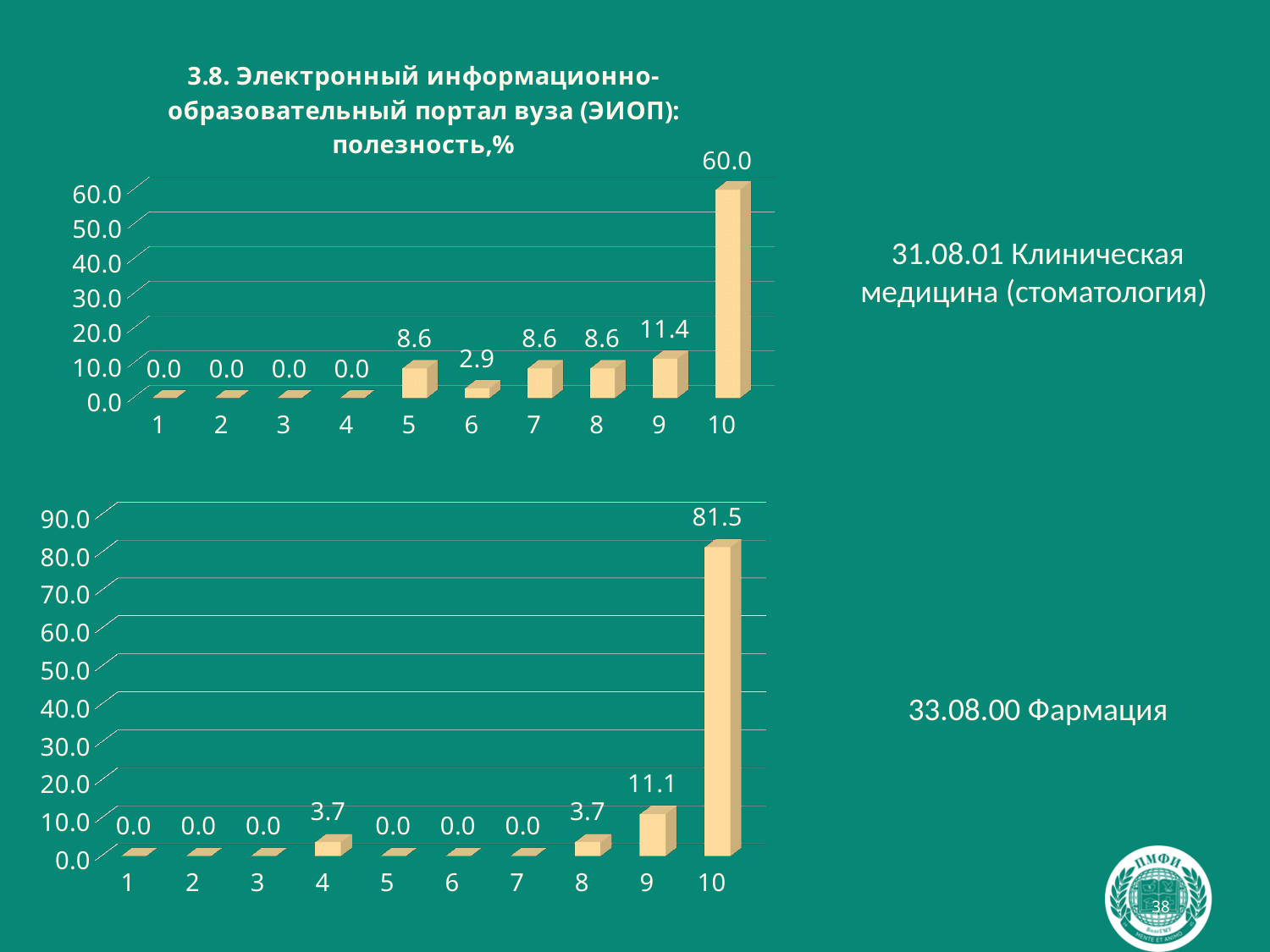
In the bottom chart (33.08.00 Фармация), what is the value for category 9? 11.1 In the top chart (31.08.01 Клиническая медицина), what is the value for category 9? 11.4 What is the title of the top chart? 3.8. Электронный информационно-образовательный портал вуза (ЭИОП): полезность,% In the bottom chart (33.08.00 Фармация), which category has the highest value? 10 In the top chart (31.08.01 Клиническая медицина), what is the difference between the values for category 10 and category 9? 48.6 In the top chart (31.08.01 Клиническая медицина), what is the value for category 10? 60.0 In the bottom chart (33.08.00 Фармация), what is the value for category 10? 81.5 In the bottom chart (33.08.00 Фармация), what is the difference between the values for category 10 and category 9? 70.4 In the top chart (31.08.01 Клиническая медицина), what is the value for category 6? 2.9 How many categories are shown on the x axis of the bottom chart (33.08.00 Фармация)? 10 What kind of chart is the top chart (31.08.01 Клиническая медицина)? bar chart In the top chart (31.08.01 Клиническая медицина), which is larger, the value for category 5 or category 6? category 5